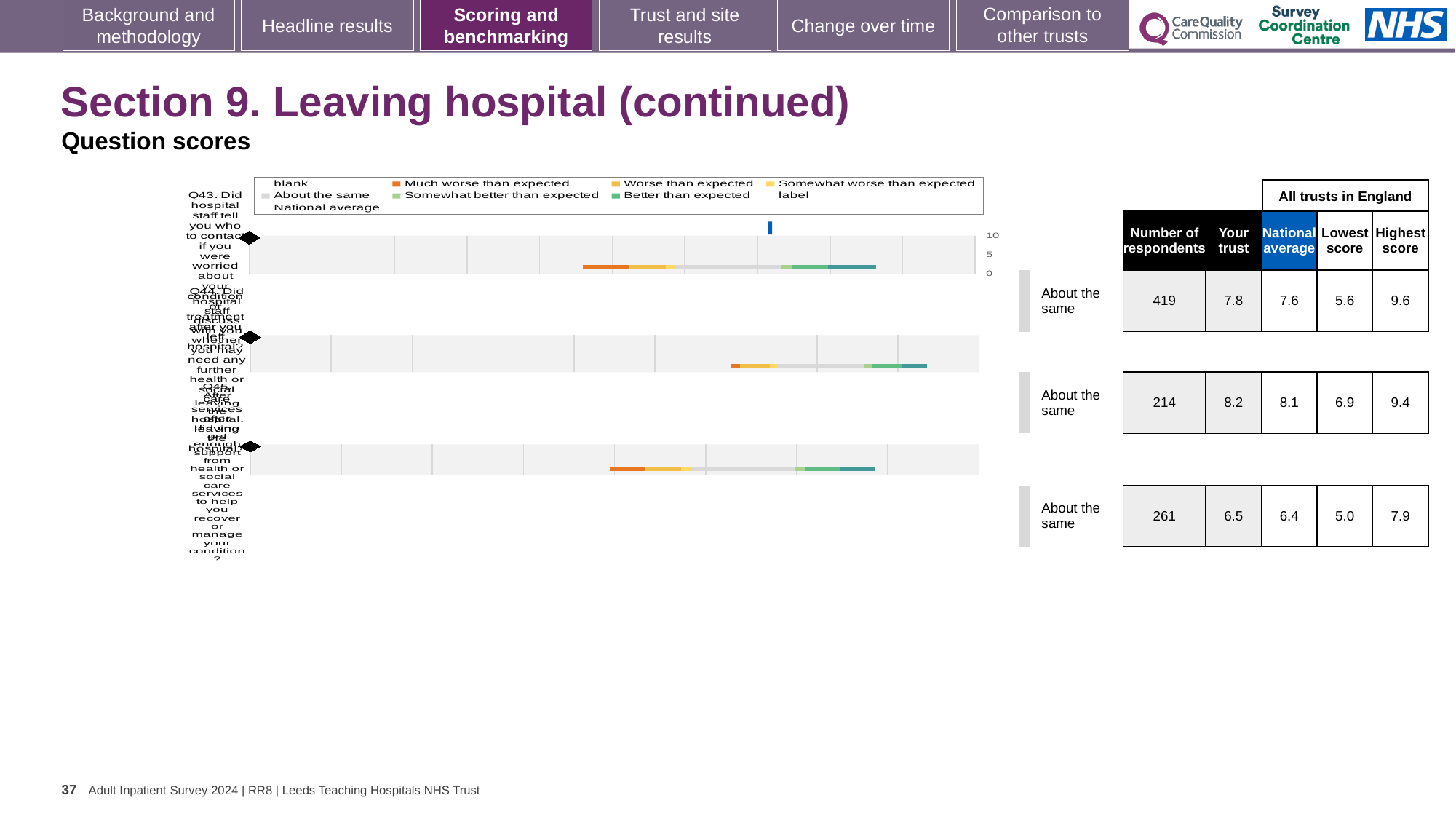
For the first question (Q43), what is the national average score shown? 7.6 Which question row has the highest 'Your trust' score? the second row (8.2) What is the maximum value shown on the score axis of the charts? 10 What benchmark category is shown beside each of the three charts? About the same For the first question (Q43), what is the 'Your trust' score shown in the table? 7.8 What kind of chart is used to show the question scores on this slide? bar chart For the third question row, which is larger: the 'Your trust' score or the national average? Your trust For the second question row, how many respondents are shown? 214 Which question row has the lowest number of respondents? the second row (214) For the third question row, what is the highest score among all trusts in England? 7.9 How many question score charts are shown on the slide? 3 For the first question (Q43), what is the difference between the highest score and the lowest score? 4.0